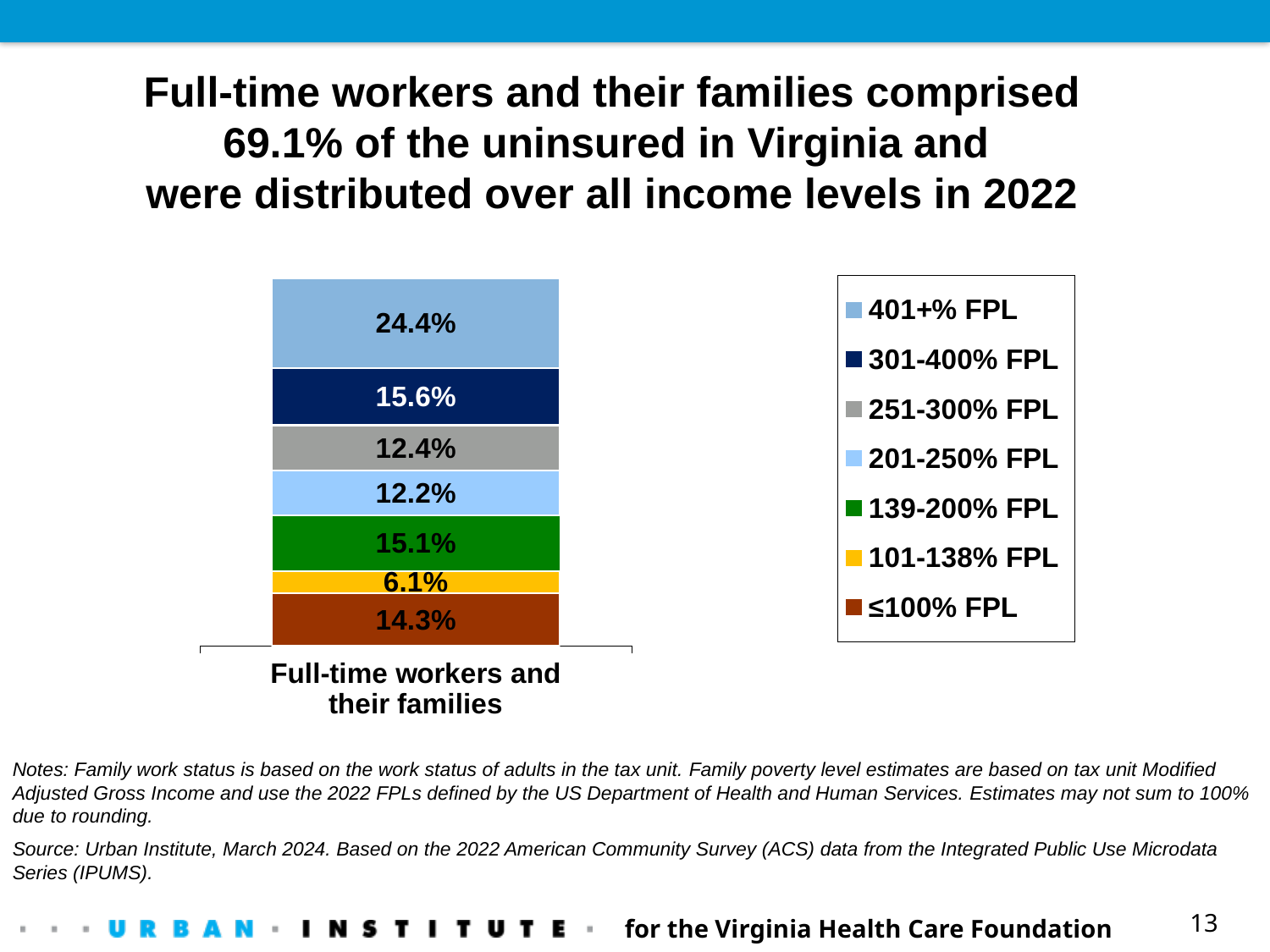
Which income level has the largest segment in the stacked bar? 401+% FPL Which is larger, the 301-400% FPL segment or the 139-200% FPL segment? 301-400% FPL What is the difference between the 401+% FPL segment and the 301-400% FPL segment? 8.8 percentage points Which income level has the smallest segment in the stacked bar? 101-138% FPL What is the value for the 301-400% FPL segment? 15.6% What colour is the ≤100% FPL segment? Brown What share of the uninsured full-time workers and their families are at 401+% FPL? 24.4% How many series does the legend list? 7 What is the value for the 101-138% FPL segment? 6.1% What is the value for the ≤100% FPL segment? 14.3% What kind of chart is shown on the slide? Stacked bar chart What is the value for the 139-200% FPL segment? 15.1%